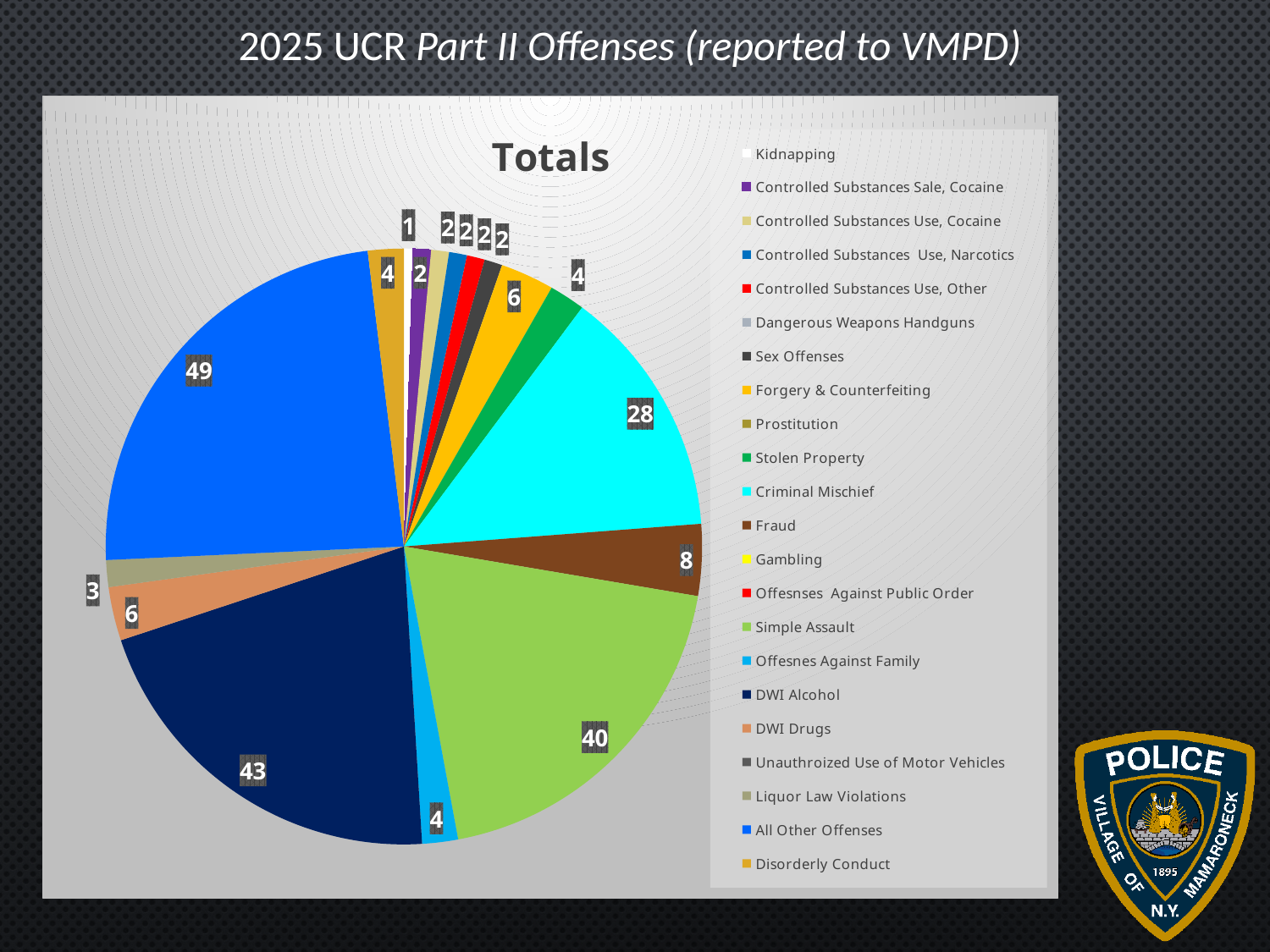
Which is larger, Simple Assault or DWI Alcohol? DWI Alcohol What is the difference between All Other Offenses and DWI Alcohol? 6 What is the value for Fraud? 8 How many entries does the chart legend list? 22 What is the value for DWI Alcohol? 43 What is the title of the chart? Totals What is the value for Simple Assault? 40 What is the value for All Other Offenses? 49 What is the difference between Simple Assault and Criminal Mischief? 12 What kind of chart is shown on the slide? pie chart Which category has the largest slice of the pie? All Other Offenses What is the value for Criminal Mischief? 28